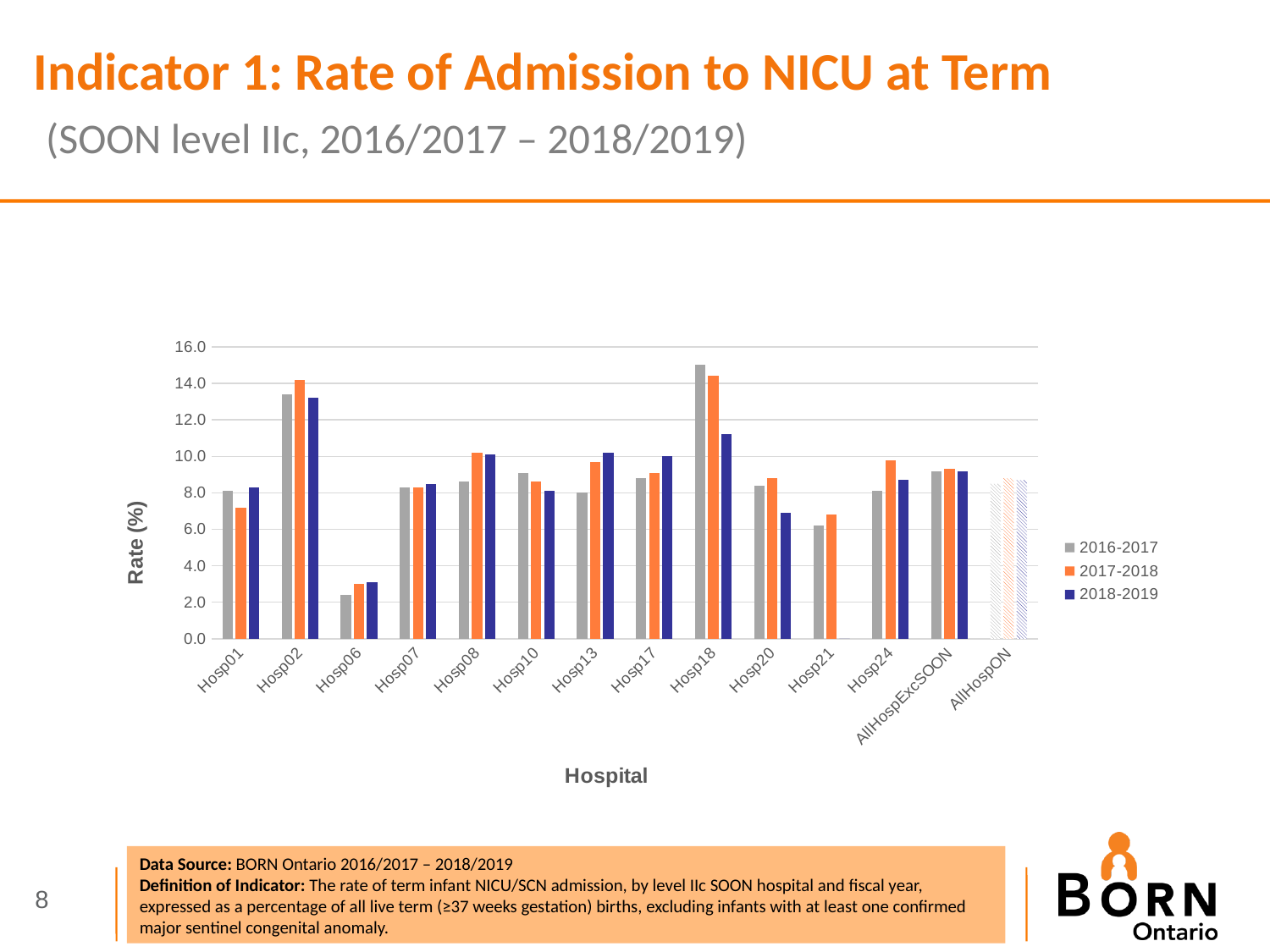
How many categories are shown along the x axis? 14 Which hospital has the highest rate for 2016-2017? Hosp18 What is the title of the vertical axis? Rate (%) Is the 2018-2019 value for Hosp18 greater or less than 10.0? greater How many series does the legend list? 3 Is the 2018-2019 value for Hosp06 greater or less than 4.0? less For 2017-2018, which has the larger rate, Hosp02 or Hosp06? Hosp02 What kind of chart is shown on the slide? Bar chart Is the 2016-2017 value for Hosp21 greater or less than 8.0? less Which hospital has the lowest rate for 2016-2017? Hosp06 For Hosp18, does the rate rise or fall from 2016-2017 to 2018-2019? fall